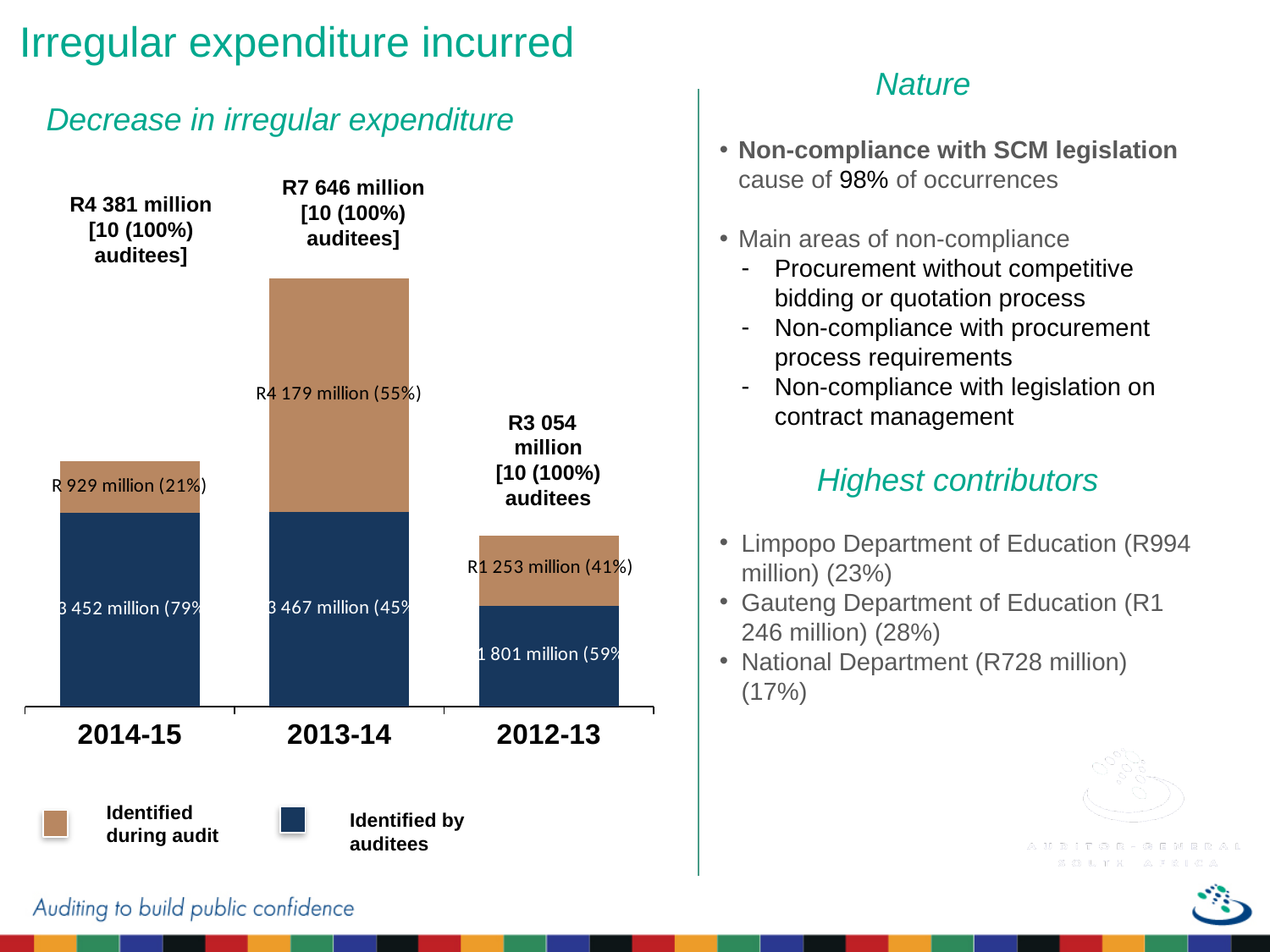
What value is labelled for 'Identified during audit' in 2013-14? R4 179 million (55%) How many series does the chart legend list? 2 What is the total irregular expenditure shown above the bar for 2012-13? R3 054 million Which legend entry is represented by the dark blue colour in the chart? Identified by auditees What is the difference between the total irregular expenditure for 2013-14 and 2014-15? R3 265 million What value is labelled for 'Identified during audit' in 2012-13? R1 253 million (41%) What is the total irregular expenditure shown above the bar for 2014-15? R4 381 million What is the total irregular expenditure shown above the bar for 2013-14? R7 646 million What type of chart is shown on the slide? Stacked bar chart Which financial year has the highest total irregular expenditure? 2013-14 How many financial years are shown on the x axis of the chart? 3 Which financial year has the lowest total irregular expenditure? 2012-13